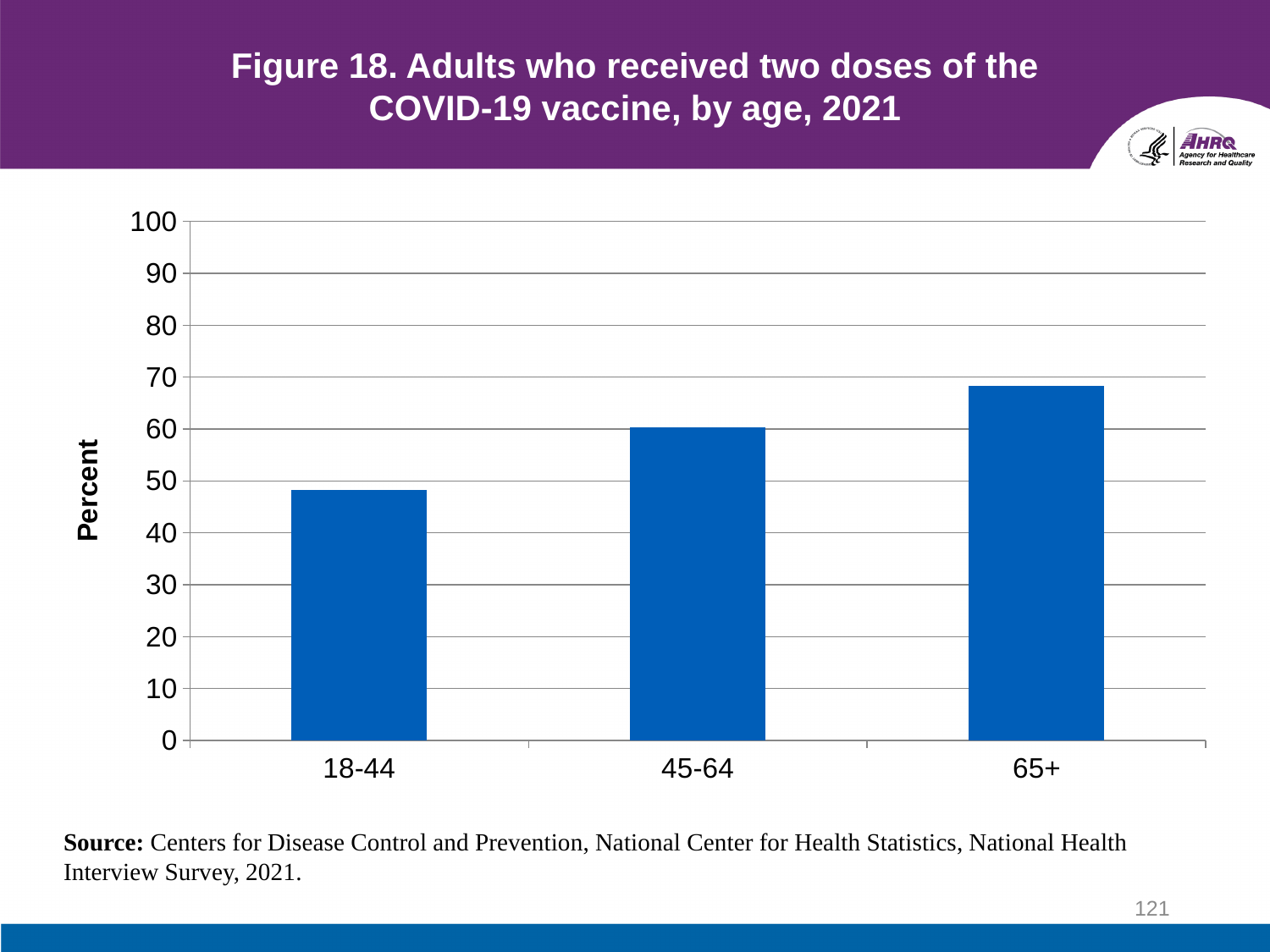
Is the value for the 65+ age group greater or less than 70? less Is the value for the 65+ age group greater or less than 60? greater Is the value for the 18-44 age group greater or less than 50? less Do the values rise or fall as age increases along the x axis? rise Which age group has the lowest percentage of adults who received two doses of the COVID-19 vaccine? 18-44 How many age groups are shown on the x axis? 3 Which age group has a larger value, 18-44 or 45-64? 45-64 Which age group has the highest percentage of adults who received two doses of the COVID-19 vaccine? 65+ What kind of chart is shown on the slide? bar chart What is the title of the chart? Figure 18. Adults who received two doses of the COVID-19 vaccine, by age, 2021 What is the label on the y axis? Percent